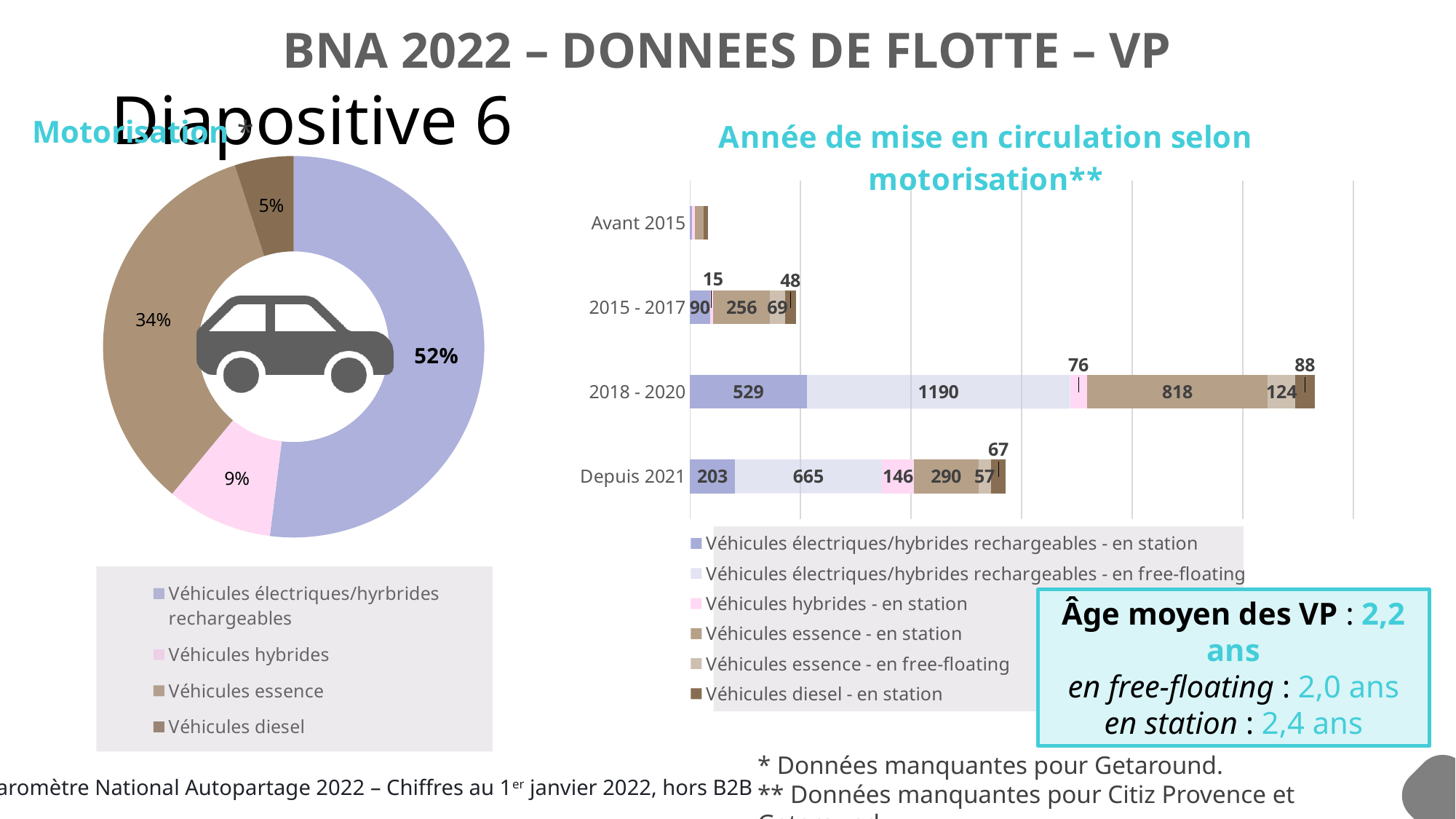
How many slices does the Motorisation pie chart have? 4 In the 'Année de mise en circulation selon motorisation' chart, what is the value for Véhicules électriques/hybrides rechargeables - en free-floating for Depuis 2021? 665 In the Motorisation pie chart, what share do Véhicules électriques/hybrides rechargeables represent? 52% How many period categories are shown on the y axis of the 'Année de mise en circulation selon motorisation' chart? 4 What kind of chart is the 'Année de mise en circulation selon motorisation' chart? Stacked bar chart In the 'Année de mise en circulation selon motorisation' chart, which period has the larger Véhicules diesel - en station value, 2018 - 2020 or Depuis 2021? 2018 - 2020 In the Motorisation pie chart, which category has the smallest slice? Véhicules diesel How many series does the legend of the 'Année de mise en circulation selon motorisation' chart list? 6 In the 'Année de mise en circulation selon motorisation' chart, what is the difference between the Véhicules électriques/hybrides rechargeables - en free-floating values for 2018 - 2020 and Depuis 2021? 525 In the Motorisation pie chart, what percentage is shown for Véhicules essence? 34% In the 'Année de mise en circulation selon motorisation' chart, what is the value for Véhicules essence - en station in 2018 - 2020? 818 In the 'Année de mise en circulation selon motorisation' chart, what is the total of the 2018 - 2020 bar? 2825